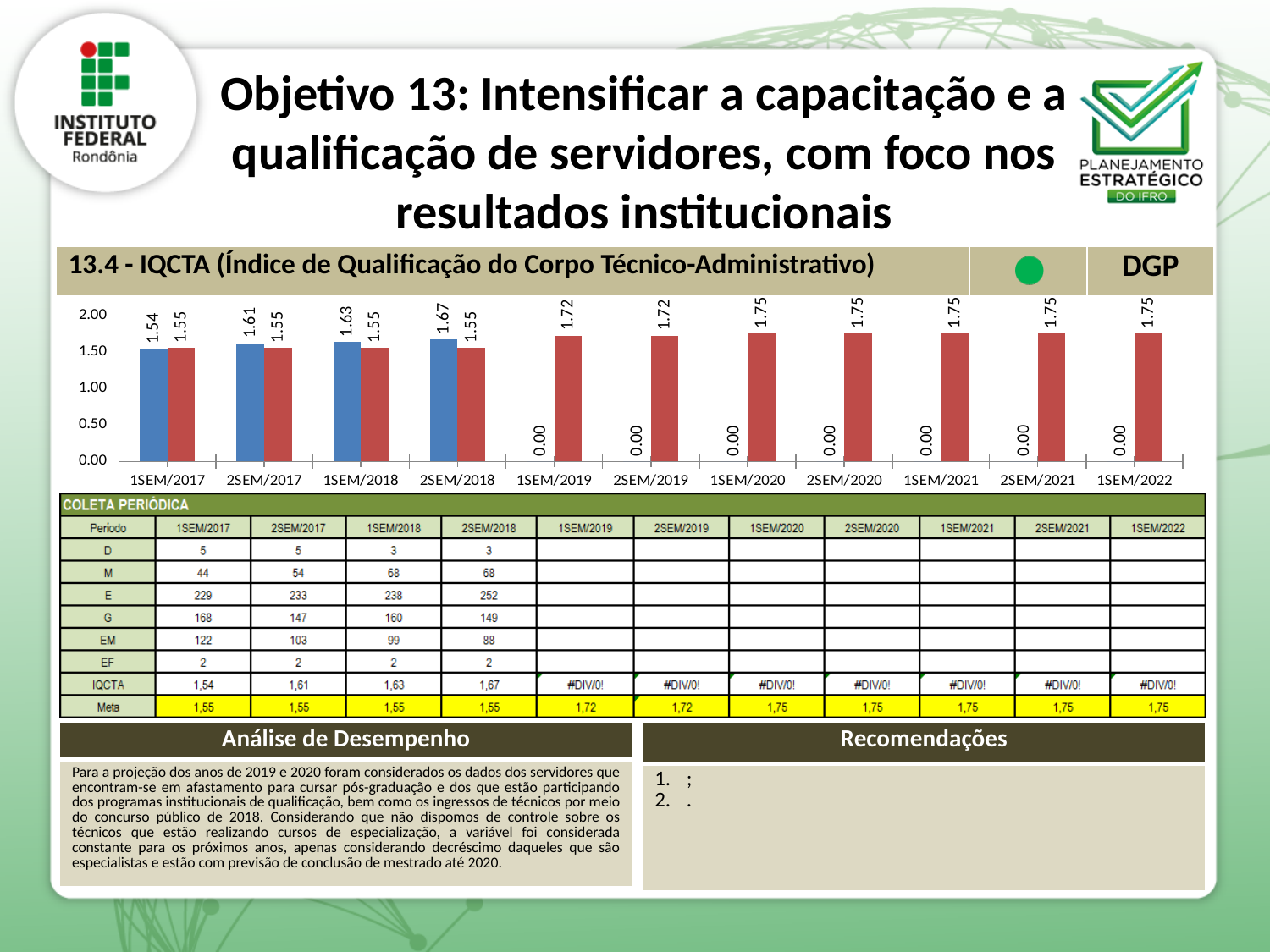
What is the difference between the blue bar and the red bar for 2SEM/2018? 0.12 What is the value of the red bar for 1SEM/2022? 1.75 What is the difference between the red bar for 1SEM/2022 and the red bar for 1SEM/2017? 0.20 How many periods are shown on the x axis of the chart? 11 Do the red bars rise or fall from 1SEM/2017 to 1SEM/2022? rise What kind of chart is shown on the slide? bar chart Which is larger for 1SEM/2017, the blue bar or the red bar? the red bar What is the value of the blue bar for 1SEM/2017? 1.54 Which period has the highest blue bar? 2SEM/2018 What is the value of the blue bar for 2SEM/2018? 1.67 What is the value of the blue bar for 1SEM/2020? 0.00 What is the value of the red bar for 1SEM/2019? 1.72